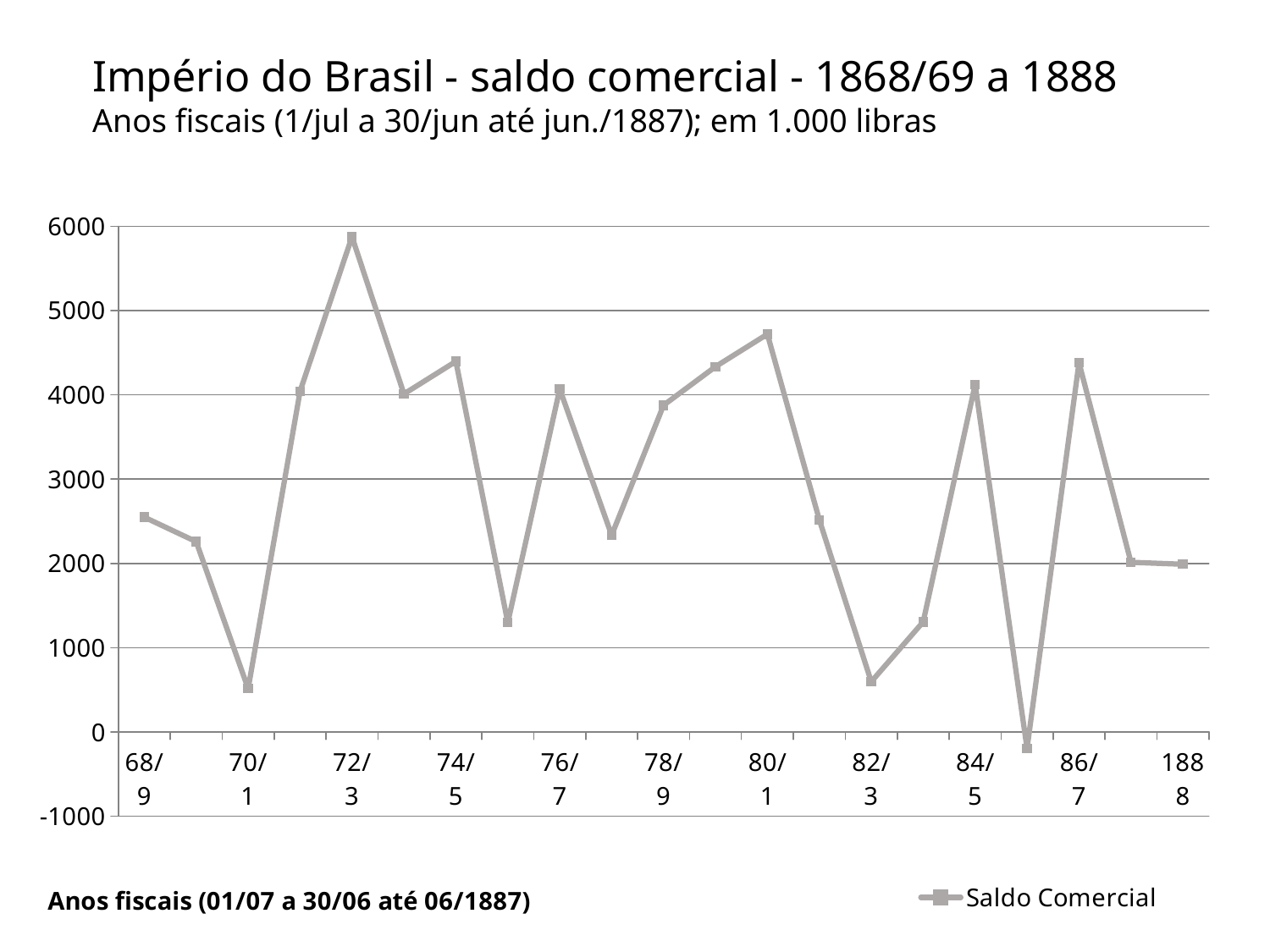
Which fiscal year has the highest value on the chart? 72/3 Is the value for 82/3 greater or less than 1000? less What is the name of the series shown in the legend? Saldo Comercial Is the value for 70/1 greater or less than 1000? less Is the value for 72/3 greater or less than 5000? greater What kind of chart is shown on the slide? line chart How many data points on the line fall below 0? 1 Does the line rise or fall from 68/9 to 70/1? fall How many series does the legend list? 1 Which is larger, the value for 72/3 or the value for 80/1? 72/3